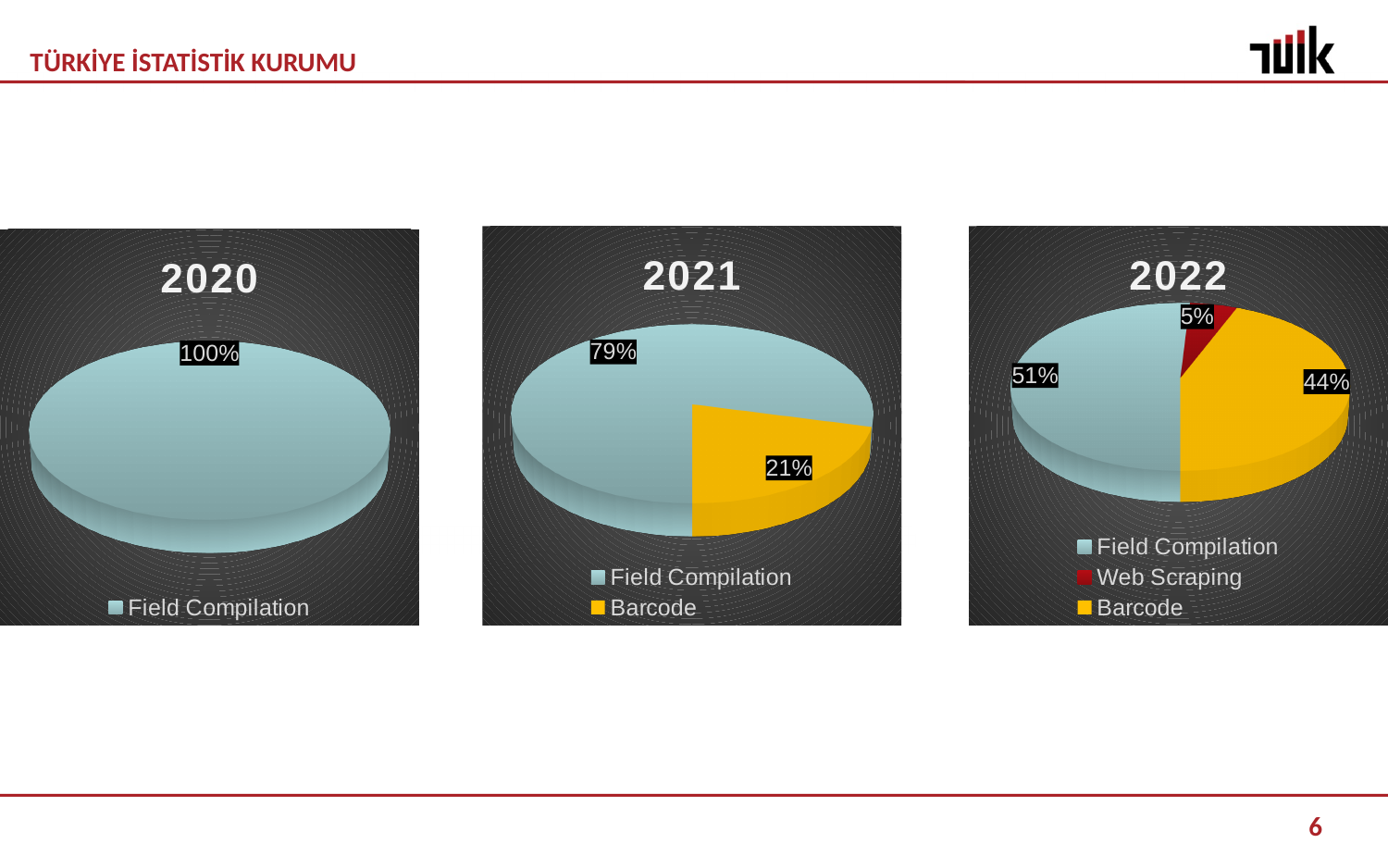
In the 2021 chart, which category has the largest slice? Field Compilation In the 2022 chart, which category has the smallest slice? Web Scraping How many categories does the legend of the 2022 chart list? 3 In the 2021 chart, what is the difference between the Field Compilation share and the Barcode share? 58% In the 2022 chart, what share does Field Compilation have? 51% In the 2022 chart, what share does Web Scraping have? 5% What kind of chart is the 2021 chart? Pie chart What colour represents Barcode in the 2021 chart? Yellow In the 2022 chart, what is the difference between the Field Compilation share and the Barcode share? 7% In the 2022 chart, which is larger, Barcode or Web Scraping? Barcode In the 2021 chart, what share does Barcode have? 21%